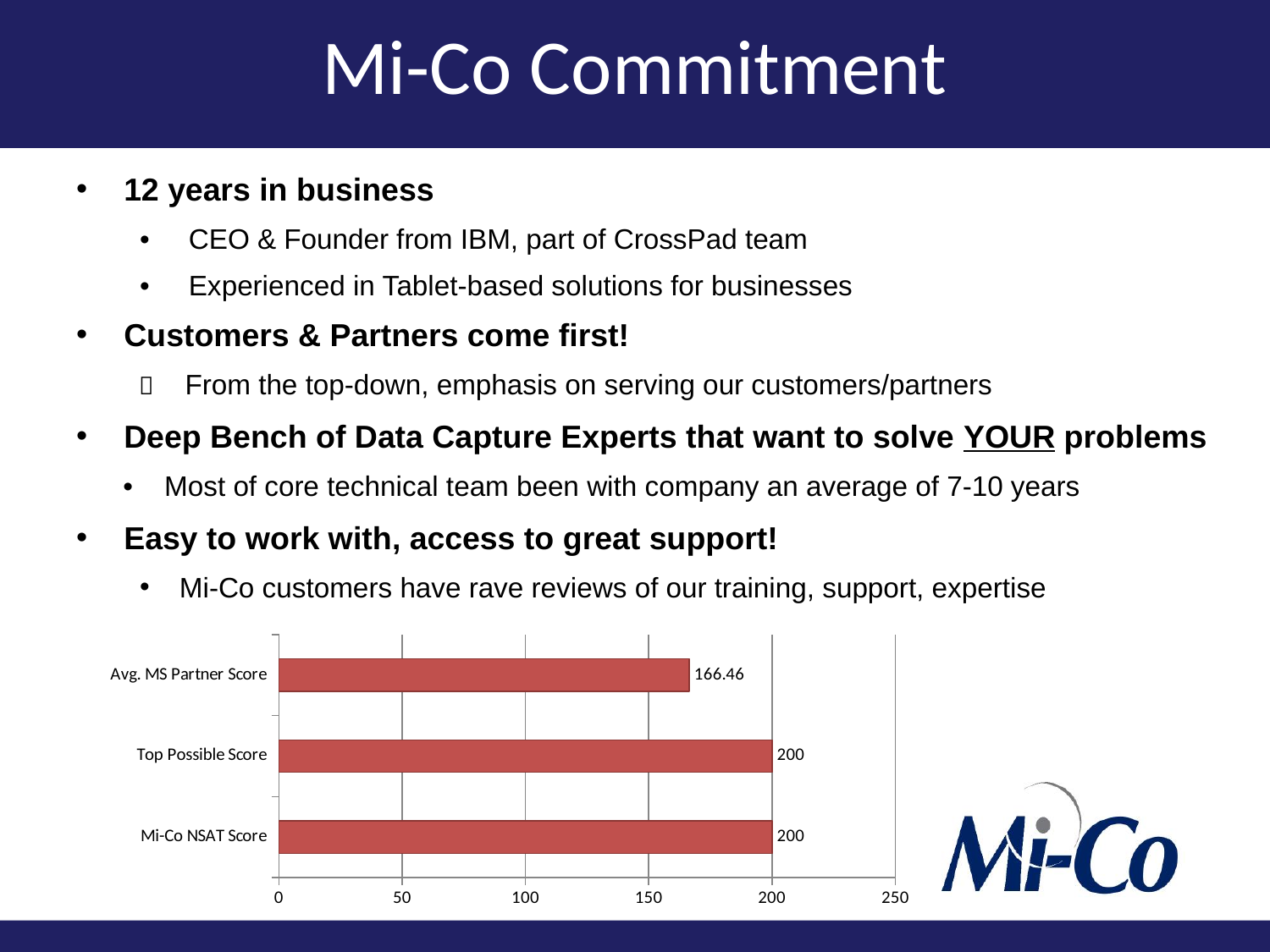
How many categories are shown in the chart? 3 What is the value for Top Possible Score? 200 What is the maximum value shown on the x axis? 250 Does the Mi-Co NSAT Score equal the Top Possible Score? Yes Which category has the lowest value? Avg. MS Partner Score Is the value for Avg. MS Partner Score greater or less than 150? greater What colour are the bars in the chart? red What kind of chart is shown on the slide? bar chart What is the value for Mi-Co NSAT Score? 200 What is the value for Avg. MS Partner Score? 166.46 Which is larger, the Mi-Co NSAT Score or the Avg. MS Partner Score? Mi-Co NSAT Score What is the difference between the Top Possible Score and the Avg. MS Partner Score? 33.54